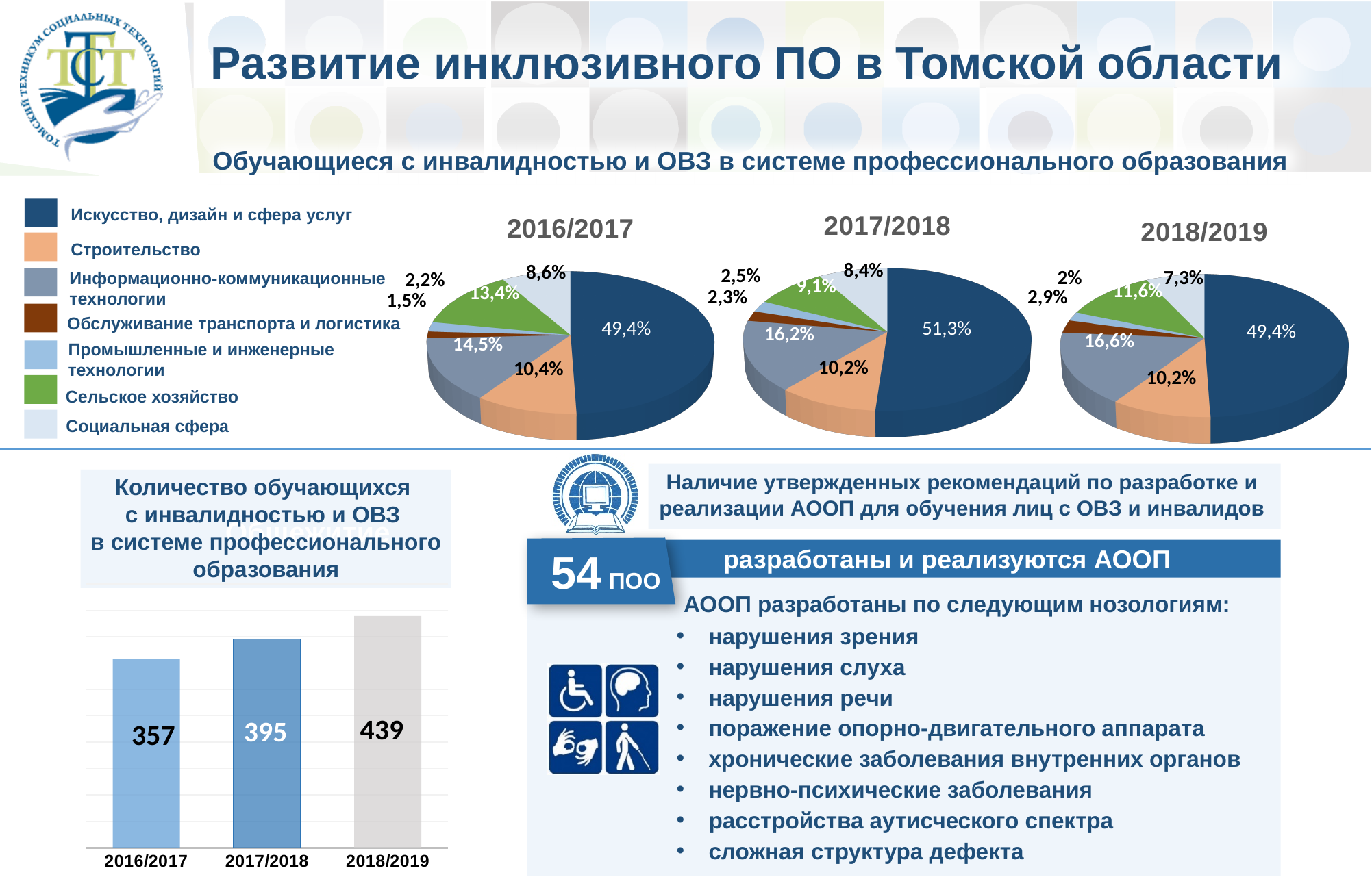
In the 2017/2018 pie chart, which category has the largest share? Искусство, дизайн и сфера услуг How many categories does the legend of the pie charts list? 7 In the bar chart 'Количество обучающихся с инвалидностью и ОВЗ в системе профессионального образования', do the values rise or fall from 2016/2017 to 2018/2019? rise In the 2016/2017 pie chart, what share is shown for Сельское хозяйство? 13,4% In the bar chart 'Количество обучающихся с инвалидностью и ОВЗ в системе профессионального образования', what is the difference between the 2018/2019 and 2016/2017 values? 82 In the 2018/2019 pie chart, what share is shown for Информационно-коммуникационные технологии? 16,6% In the 2016/2017 pie chart, what share is shown for Искусство, дизайн и сфера услуг? 49,4% What kind of chart is the chart at the bottom left of the slide? bar chart In the 2018/2019 pie chart, what share is shown for Социальная сфера? 7,3% In the 2017/2018 pie chart, what share is shown for Искусство, дизайн и сфера услуг? 51,3% In the 2016/2017 pie chart, which is larger: the share for Строительство or the share for Информационно-коммуникационные технологии? Информационно-коммуникационные технологии In the bar chart 'Количество обучающихся с инвалидностью и ОВЗ в системе профессионального образования', what is the value for 2017/2018? 395